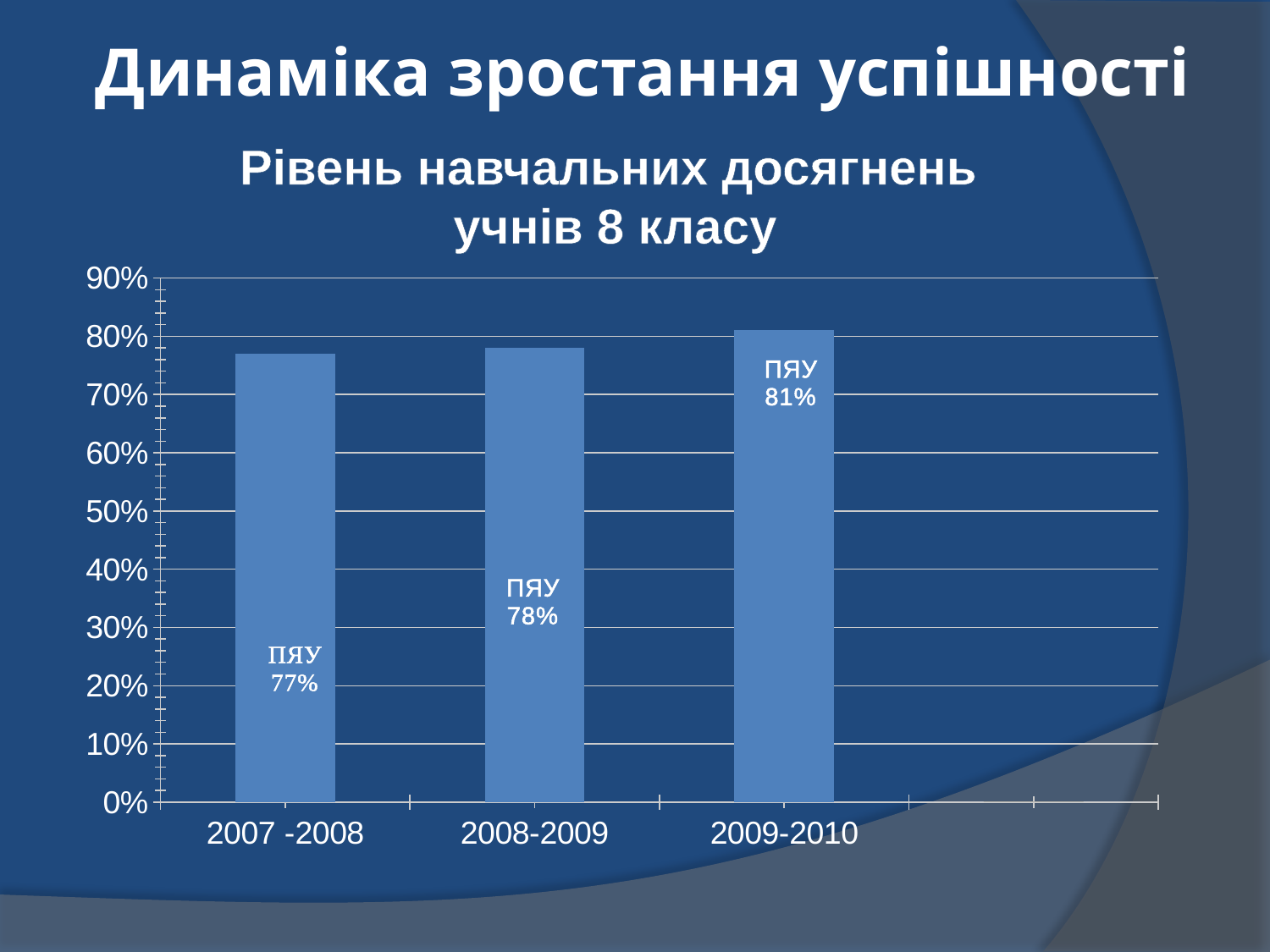
What kind of chart is shown on the slide? bar chart Which school year has the lowest value? 2007 -2008 What is the value for 2009-2010? 81% What is the difference between the values for 2009-2010 and 2008-2009? 3% How many school years are shown on the chart? 3 What is the value for 2008-2009? 78% Do the values rise or fall from 2007 -2008 to 2009-2010? rise Which is larger, the value for 2007 -2008 or the value for 2009-2010? 2009-2010 What is the difference between the values for 2009-2010 and 2007 -2008? 4% Is the value for 2009-2010 greater or less than 80%? greater Which school year has the highest value? 2009-2010 What is the value for 2007 -2008? 77%